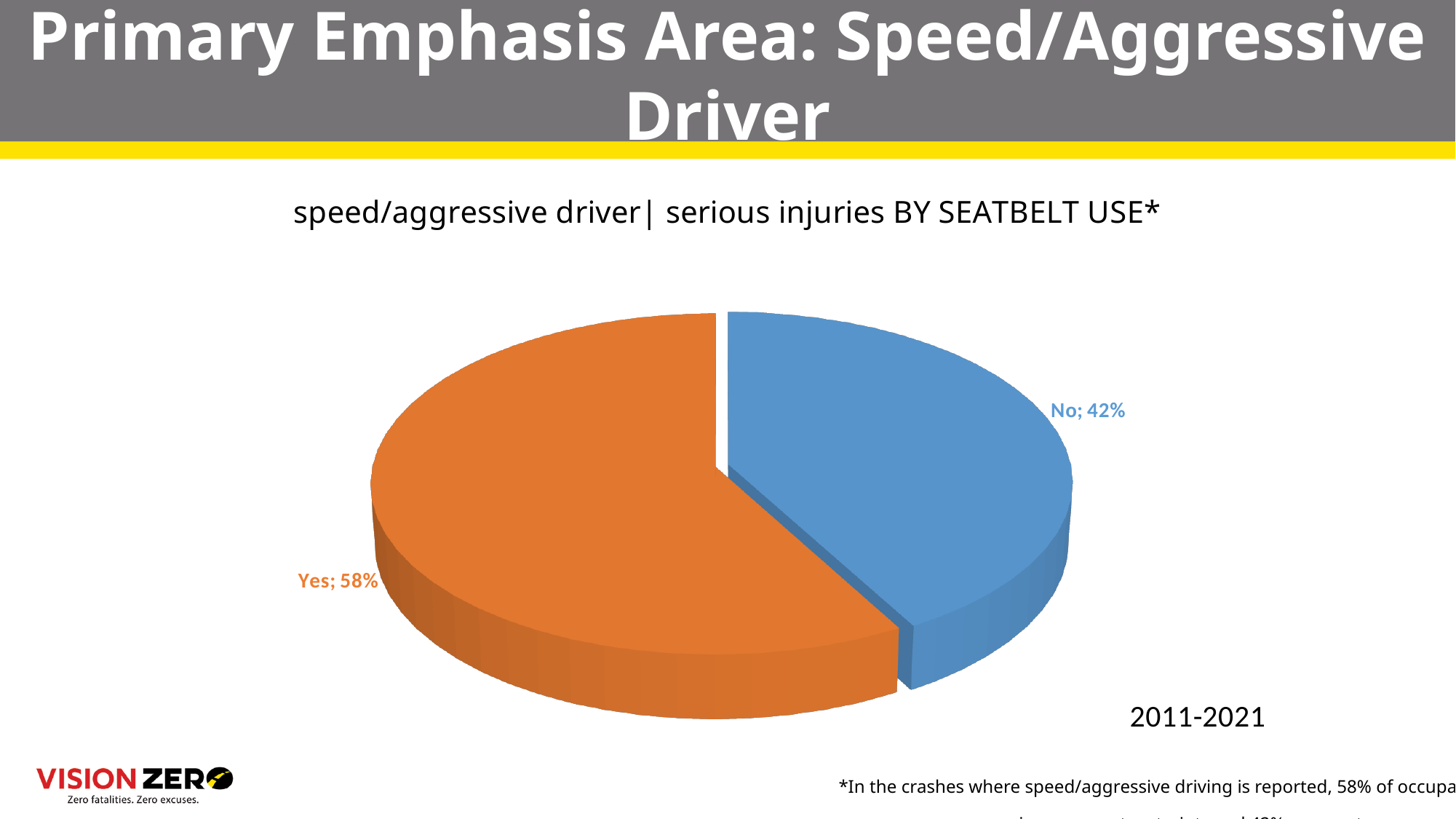
Is the share for "No" greater or less than 50%? less Which is larger, the "Yes" slice or the "No" slice? Yes Which slice of the pie is the smallest? No Which slice of the pie is the largest? Yes What is the title of the chart? speed/aggressive driver| serious injuries BY SEATBELT USE* What is the difference in percentage points between the "Yes" and "No" slices? 16 What share of serious injuries is labelled "Yes" for seatbelt use? 58% What share of serious injuries is labelled "No" for seatbelt use? 42% What colour is the "No" slice of the pie? blue How many slices does the pie chart have? 2 What kind of chart is shown on the slide? pie chart What time period is shown next to the chart? 2011-2021